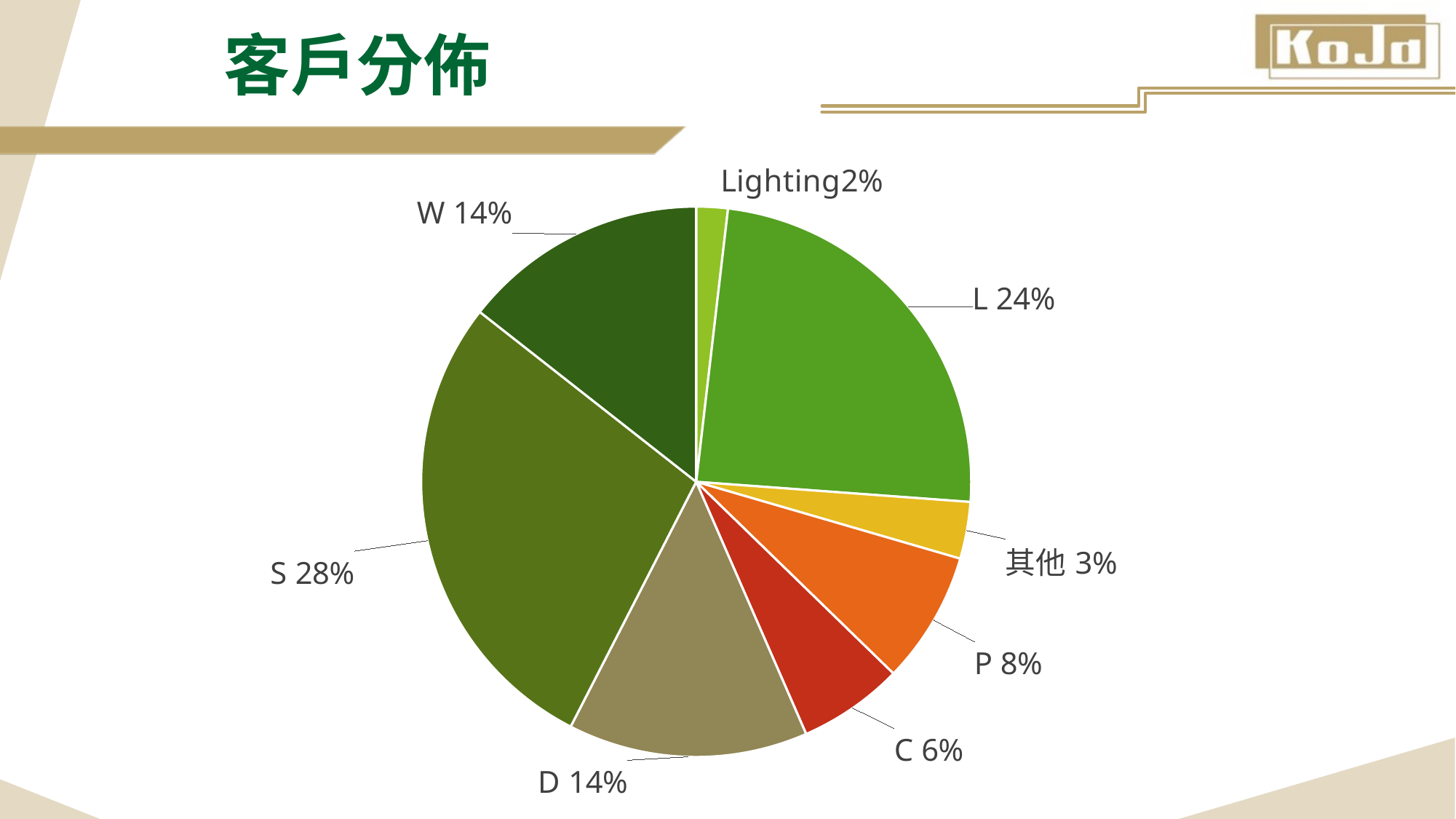
Which category has the largest slice of the pie? S What is the value shown for L? 24% Which category has the smallest slice of the pie? Lighting Which is larger, the share for P or the share for C? P What is the value shown for 其他? 3% What share of the pie does S account for? 28% How many slices does the pie chart have? 8 What is the combined share of D and W? 28% What is the title of the chart on the slide? 客戶分佈 What is the value shown for Lighting? 2% What is the difference between the shares of S and L? 4% What kind of chart is shown on the slide? pie chart